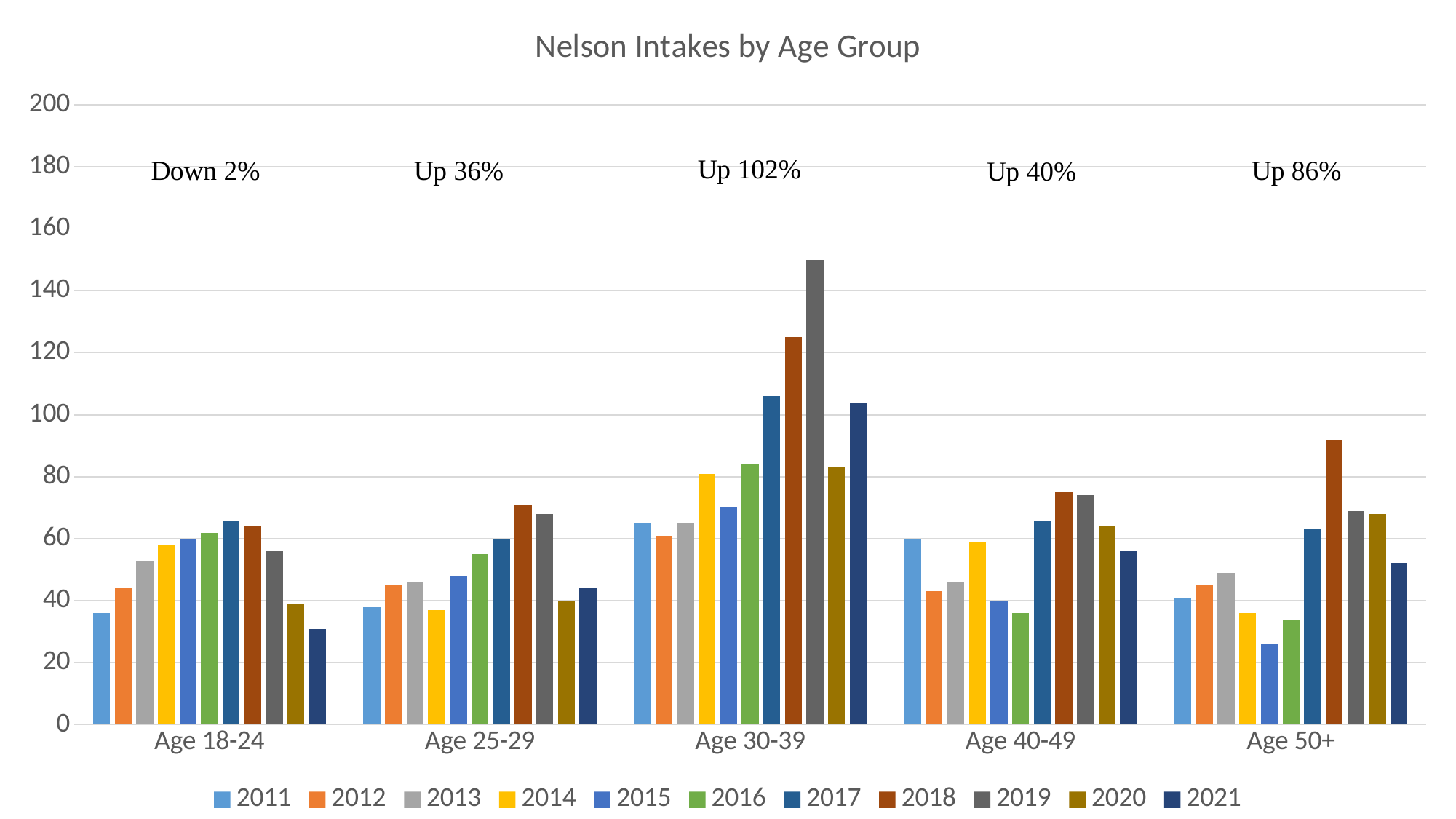
How many age groups are shown on the x axis? 5 Is the value for 2016 in the Age 40-49 group greater or less than 40? less How many series does the legend list? 11 What percentage change is annotated above the Age 30-39 group? Up 102% Is the value for 2019 in the Age 30-39 group greater or less than 140? greater What kind of chart is shown on the slide? bar chart In the Age 50+ group, which is larger: the value for 2018 or the value for 2011? 2018 Within the Age 30-39 group, which year has the highest value? 2019 In the Age 18-24 group, which is larger: the value for 2019 or the value for 2021? 2019 Is the value for 2018 in the Age 50+ group greater or less than 80? greater Within the Age 50+ group, which year has the lowest value? 2015